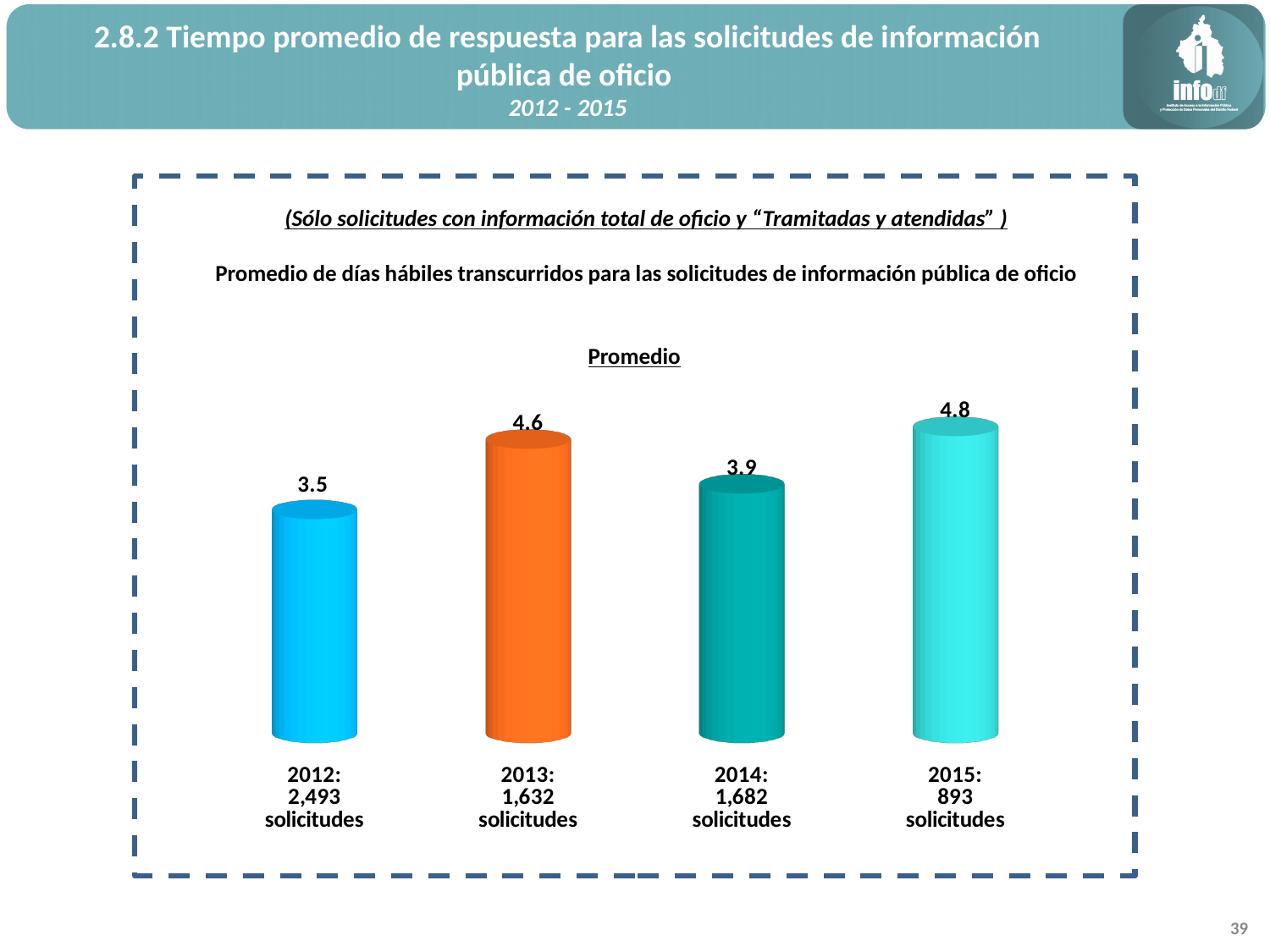
What is the average value shown for 2013? 4.6 Which year has the highest average value? 2015 What is the difference between the average values for 2015 and 2012? 1.3 What kind of chart is shown on the slide? Bar chart What is the average value shown for 2015? 4.8 Which is larger, the average value for 2013 or for 2014? 2013 What is the title printed directly above the bars? Promedio What is the average value shown for 2012? 3.5 How many solicitudes are listed under the 2012 bar? 2,493 How many years are shown in the chart? 4 What is the average value shown for 2014? 3.9 Which year has the lowest average value? 2012